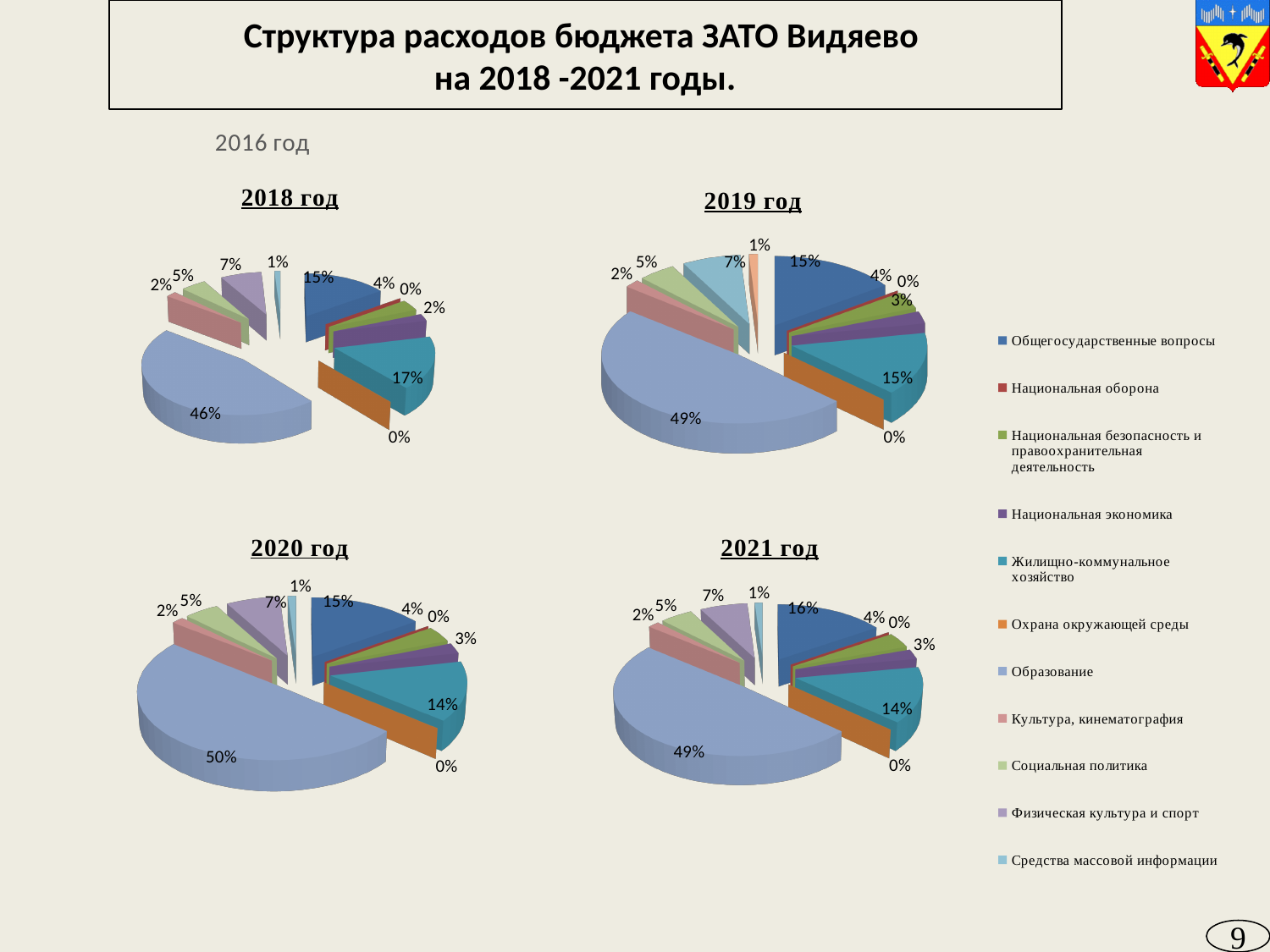
In the 2018 год pie chart, what share is shown for Жилищно-коммунальное хозяйство? 17% In the 2018 год pie chart, which is larger: Общегосударственные вопросы or Жилищно-коммунальное хозяйство? Жилищно-коммунальное хозяйство By how many percentage points is the Образование share in the 2020 год chart larger than in the 2018 год chart? 4 percentage points In the 2018 год pie chart, what share is shown for Образование? 46% In the 2020 год pie chart, which category has the largest slice? Образование In the 2021 год pie chart, what share is shown for Физическая культура и спорт? 7% In the 2020 год pie chart, what share is shown for Жилищно-коммунальное хозяйство? 14% How many pie charts are shown on the slide? 4 How many categories does the shared legend list for the pie charts? 11 What kind of chart is used for the 2019 год data? Pie chart In the 2019 год pie chart, what share is shown for Общегосударственные вопросы? 15% In the 2021 год pie chart, what share is shown for Общегосударственные вопросы? 16%